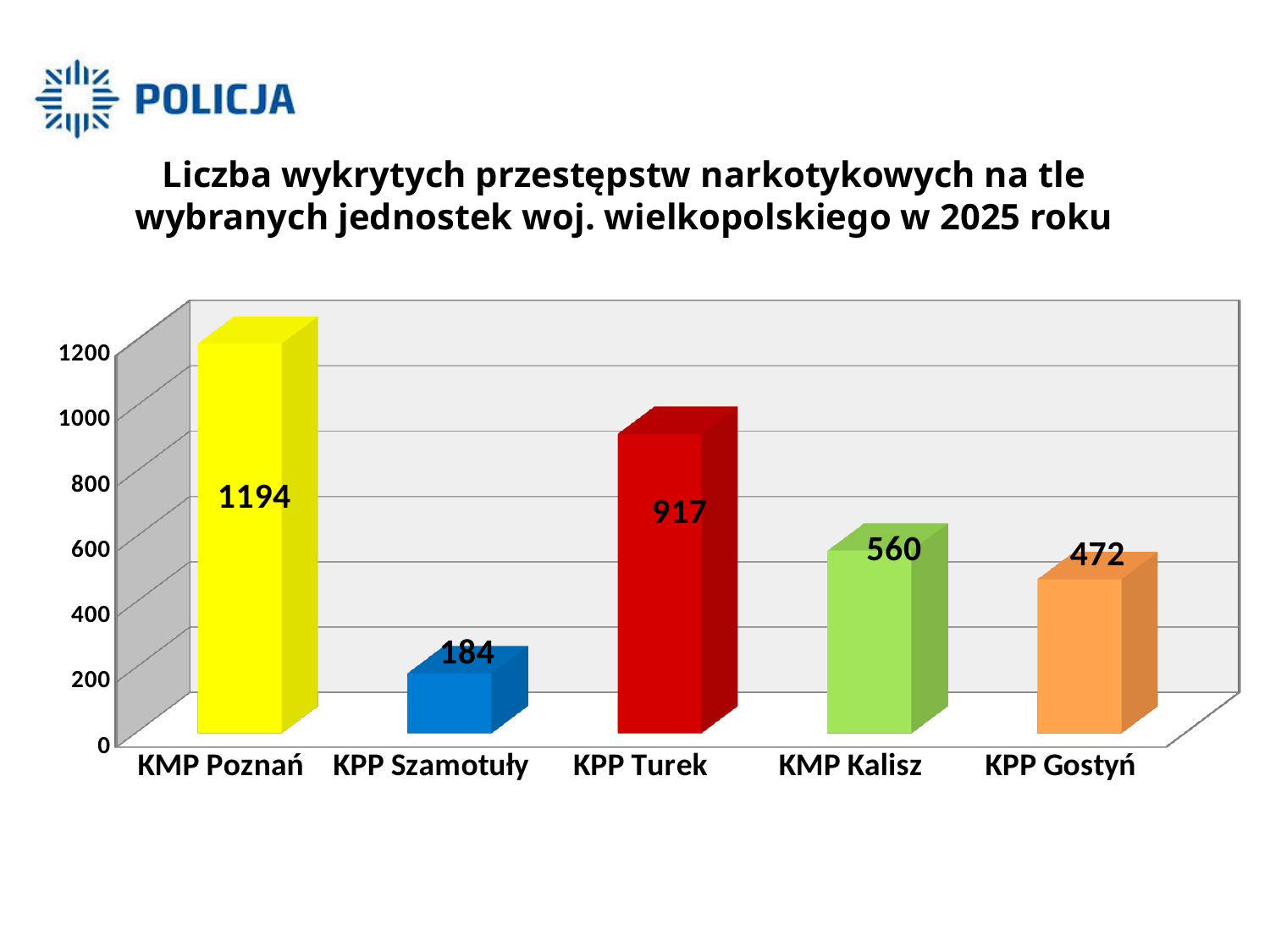
Which is larger, the value for KMP Kalisz or the value for KPP Gostyń? KMP Kalisz What is the value for KMP Poznań? 1194 What is the value for KPP Turek? 917 Which unit has the highest number of detected drug crimes? KMP Poznań What colour is the bar for KPP Turek? Red What is the value for KPP Szamotuły? 184 What is the value for KMP Kalisz? 560 Which unit has the lowest number of detected drug crimes? KPP Szamotuły How many units are shown on the chart? 5 What is the value for KPP Gostyń? 472 What kind of chart is shown on the slide? Bar chart What is the difference between the values for KMP Poznań and KPP Turek? 277